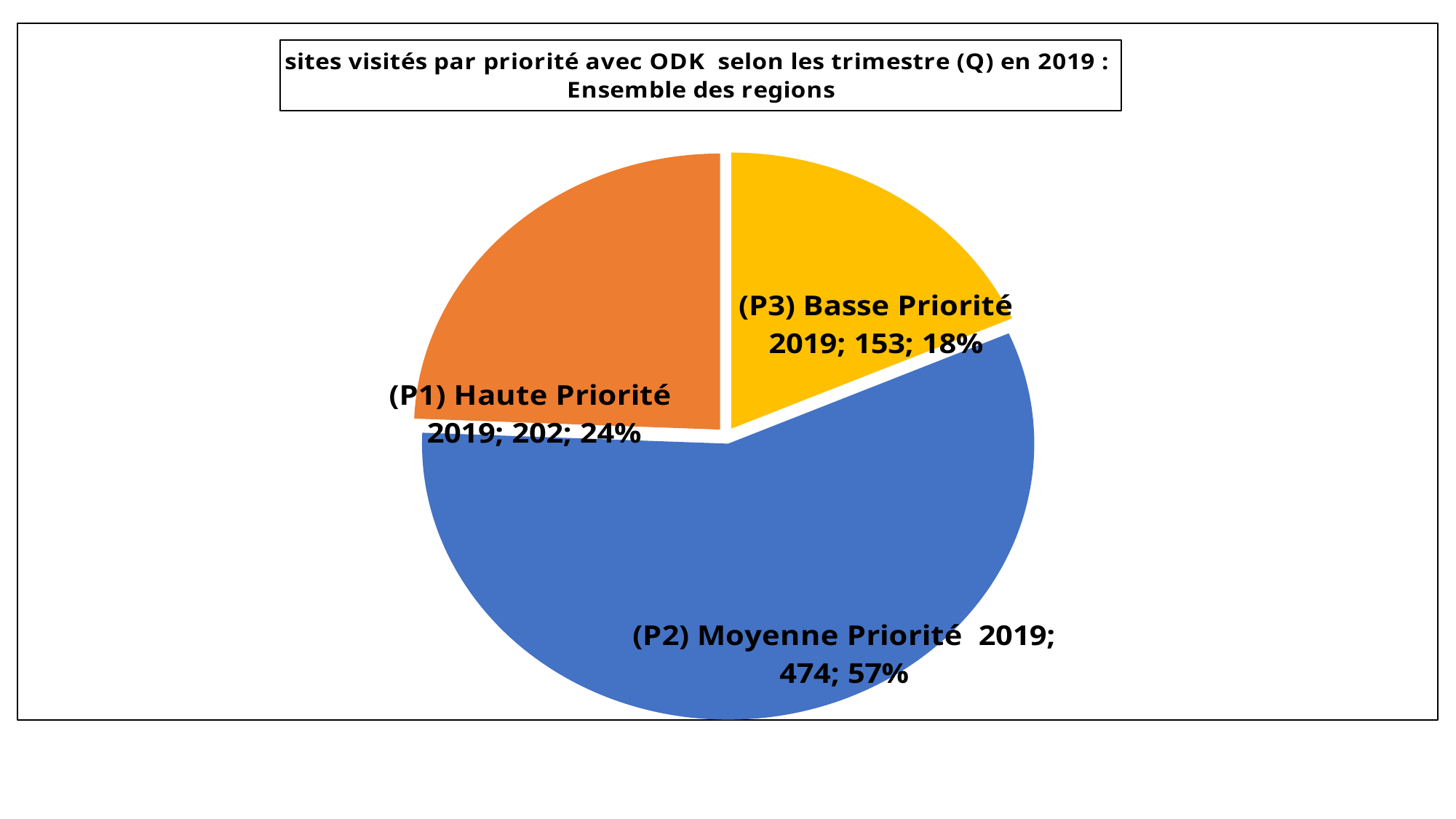
What is the difference between the values for (P1) Haute Priorité 2019 and (P3) Basse Priorité 2019? 49 Which is larger, the value for (P1) Haute Priorité 2019 or (P3) Basse Priorité 2019? (P1) Haute Priorité 2019 What is the value for (P1) Haute Priorité 2019? 202 What share of the pie does (P2) Moyenne Priorité 2019 represent? 57% What type of chart is shown on the slide? pie chart Which category has the smallest slice? (P3) Basse Priorité 2019 What is the value for (P2) Moyenne Priorité 2019? 474 How many slices does the pie chart have? 3 What share of the pie does (P3) Basse Priorité 2019 represent? 18% What is the value for (P3) Basse Priorité 2019? 153 Which category has the largest slice? (P2) Moyenne Priorité 2019 What colour is the slice for (P2) Moyenne Priorité 2019? blue